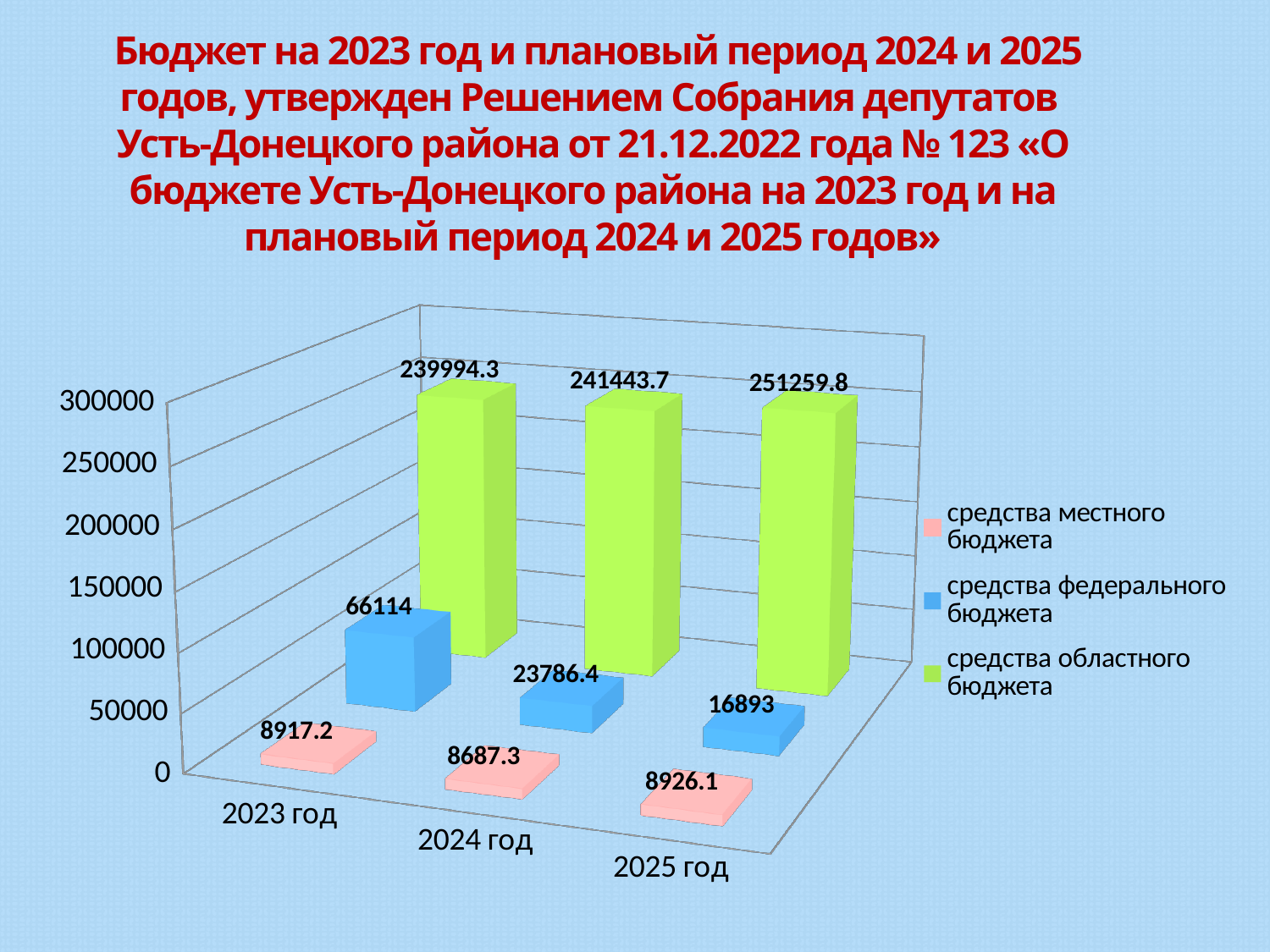
What is the value for средства федерального бюджета in 2024 год? 23786.4 How many years are shown on the x axis? 3 In which year is средства федерального бюджета the highest? 2023 год In which year is средства федерального бюджета the lowest? 2025 год What is the difference between средства областного бюджета in 2025 год and 2023 год? 11265.5 Is the value for средства областного бюджета in 2025 год greater or less than 200000? greater What is the difference between средства федерального бюджета in 2023 год and 2024 год? 42327.6 What is the value for средства местного бюджета in 2025 год? 8926.1 How many series does the legend list? 3 Do the values for средства областного бюджета rise or fall from 2023 год to 2025 год? rise What is the value for средства областного бюджета in 2023 год? 239994.3 Which is larger: средства местного бюджета in 2023 год or средства федерального бюджета in 2023 год? средства федерального бюджета in 2023 год